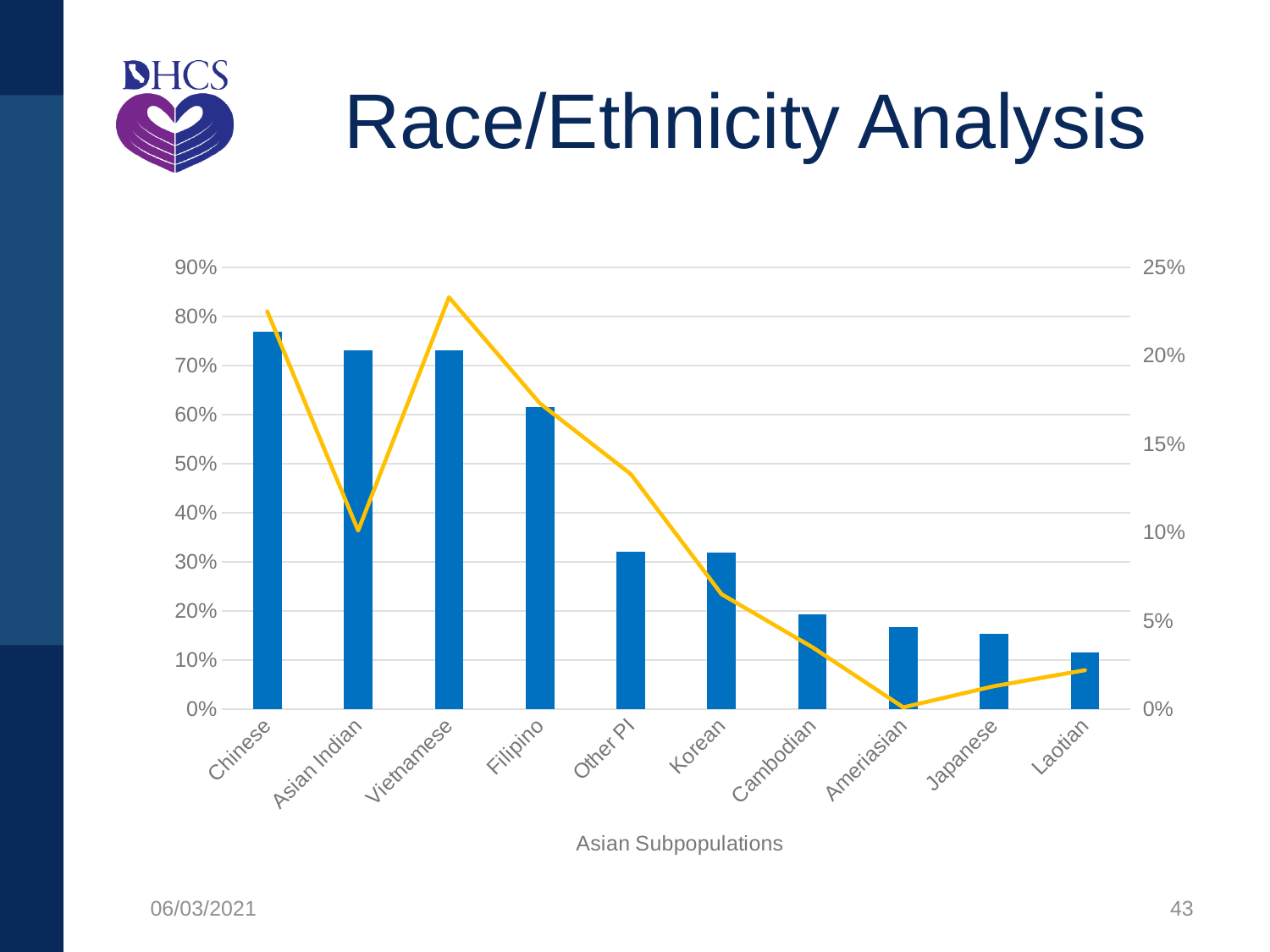
Which has the taller bar, Cambodian or Laotian? Cambodian Is the bar value for Chinese greater or less than 70%? greater Which Asian subpopulation has the tallest bar in the chart? Chinese Which Asian subpopulation has the shortest bar in the chart? Laotian How many Asian subpopulation categories are shown on the x axis of the chart? 10 Is the bar value for Laotian greater or less than 20%? less Do the bar values generally rise or fall moving from left to right along the x axis? fall Is the bar value for Other PI greater or less than 20%? greater What is the title of the x axis of the chart? Asian Subpopulations Which has the taller bar, Filipino or Other PI? Filipino At which Asian subpopulation does the yellow line reach its lowest point? Ameriasian